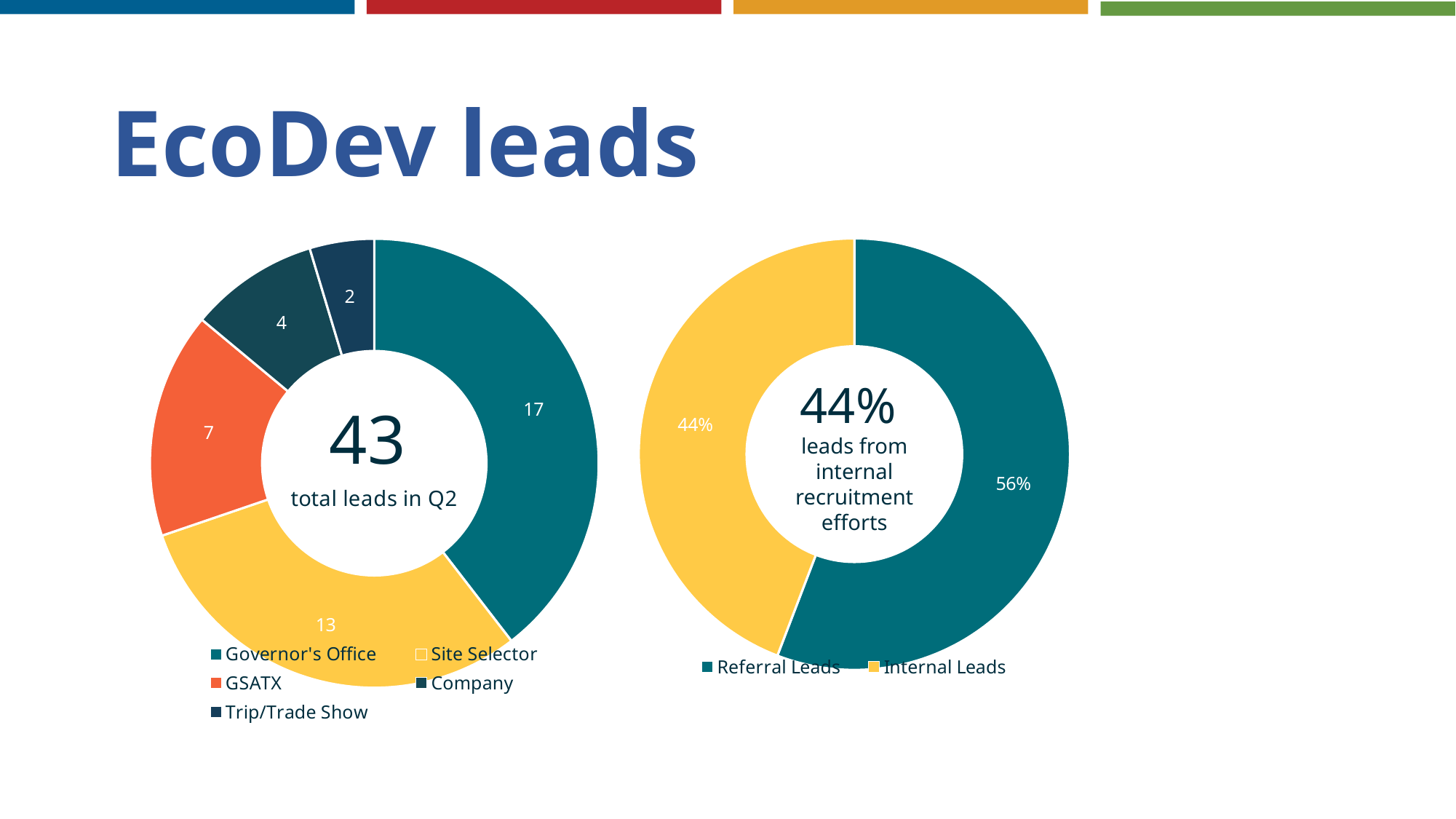
In the left chart (total leads in Q2), how many leads came from the Governor's Office? 17 In the right chart, what share of leads are Internal Leads? 44% What kind of chart is the right chart (Referral Leads vs Internal Leads)? Doughnut (pie) chart In the left chart (total leads in Q2), what is the difference between the Governor's Office leads and the Site Selector leads? 4 In the left chart, what is the total number of leads in Q2 shown in the centre? 43 In the left chart (total leads in Q2), which is larger: GSATX or Company? GSATX In the left chart (total leads in Q2), how many leads came from Trip/Trade Show? 2 In the left chart (total leads in Q2), which lead source has the lowest value? Trip/Trade Show In the left chart (total leads in Q2), how many lead source categories are shown? 5 In the right chart, what share of leads are Referral Leads? 56% In the left chart (total leads in Q2), which lead source has the highest value? Governor's Office In the left chart (total leads in Q2), how many leads came from GSATX? 7